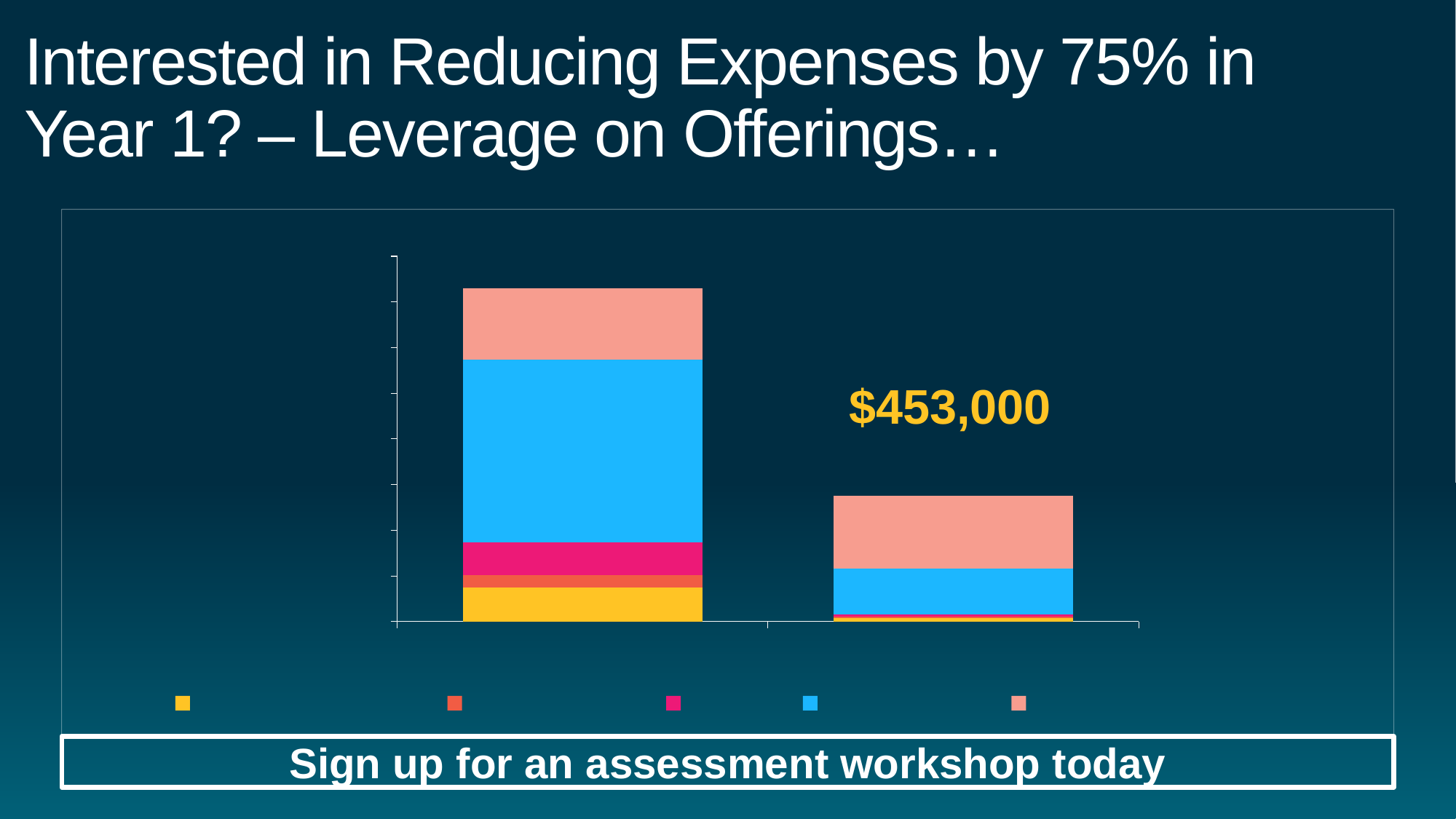
Which colour segment is the largest in the left bar? Blue What kind of chart is shown on the slide? Stacked bar chart Which bar has the lowest total height? The right bar Which bar is taller, the left bar or the right bar? The left bar Which colour segment is at the top of both stacked bars? Salmon pink What value is printed above the right-hand bar? $453,000 How many bars are plotted in the chart? 2 Do the bar totals rise or fall from left to right across the chart? Fall How many series does the legend below the chart list? 5